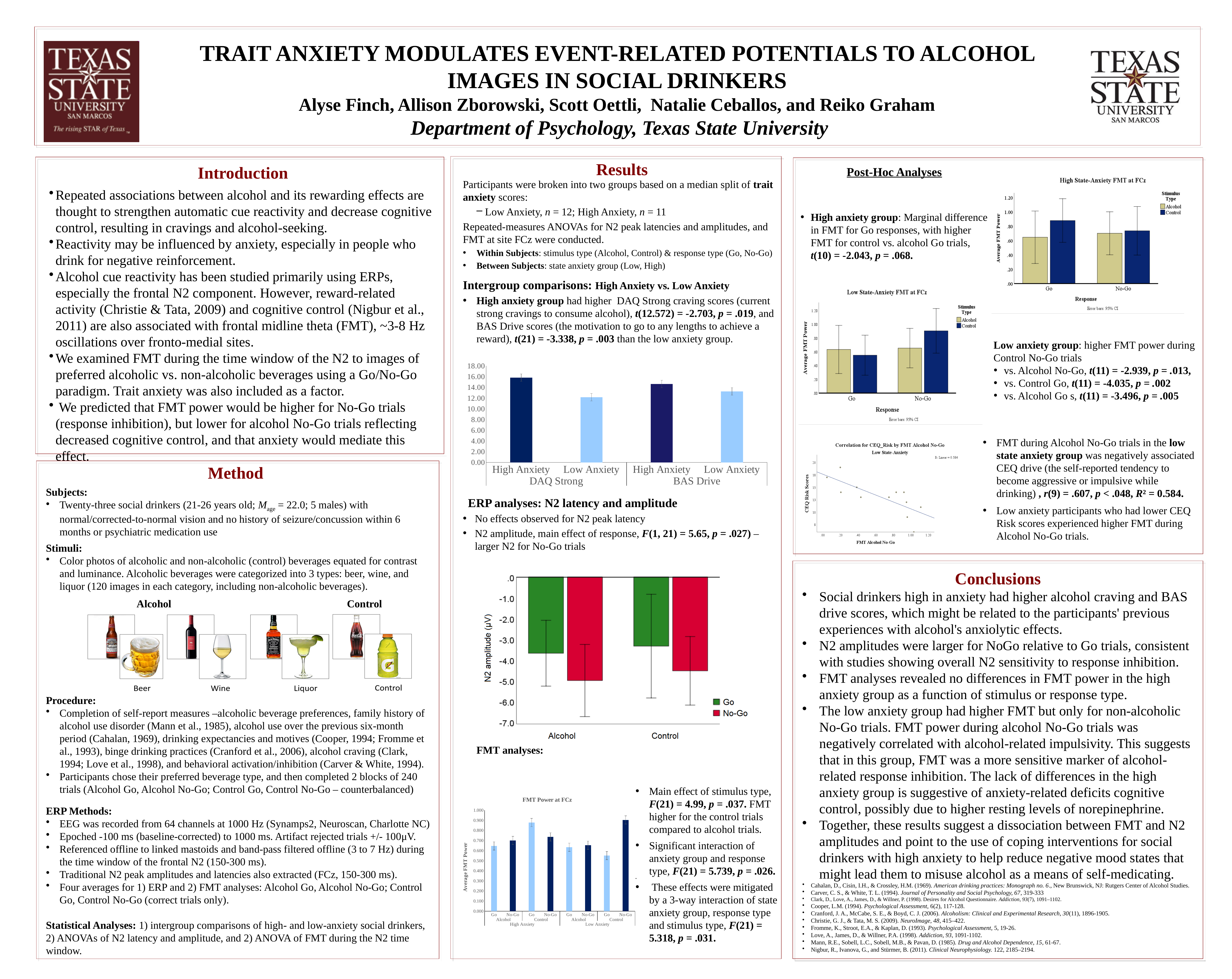
In the N2 amplitude chart, what colour represents No-Go trials? red In the DAQ Strong / BAS Drive bar chart, which is larger for DAQ Strong: High Anxiety or Low Anxiety? High Anxiety In the DAQ Strong / BAS Drive bar chart, is the value for High Anxiety DAQ Strong greater or less than 14.00? greater In the High State-Anxiety FMT at FCz chart, which is larger for Go responses: Alcohol or Control? Control In the N2 amplitude chart, is the No-Go value for Alcohol greater or less than -4.0? less In the DAQ Strong / BAS Drive bar chart, which bar is the lowest? Low Anxiety DAQ Strong What kind of chart is the chart with DAQ Strong and BAS Drive on the x axis in the Results section? bar chart In the Correlation for CEQ_Risk by FMT Alcohol No-Go chart, do CEQ Risk Scores rise or fall as FMT Alcohol No-Go increases? fall In the FMT Power at FCz chart at the bottom of the Results section, is the value for High Anxiety Control Go greater or less than 0.800? greater In the N2 amplitude chart, how many series does the legend list? 2 In the DAQ Strong / BAS Drive bar chart, which bar is the highest? High Anxiety DAQ Strong In the DAQ Strong / BAS Drive bar chart, how many bars are plotted? 4